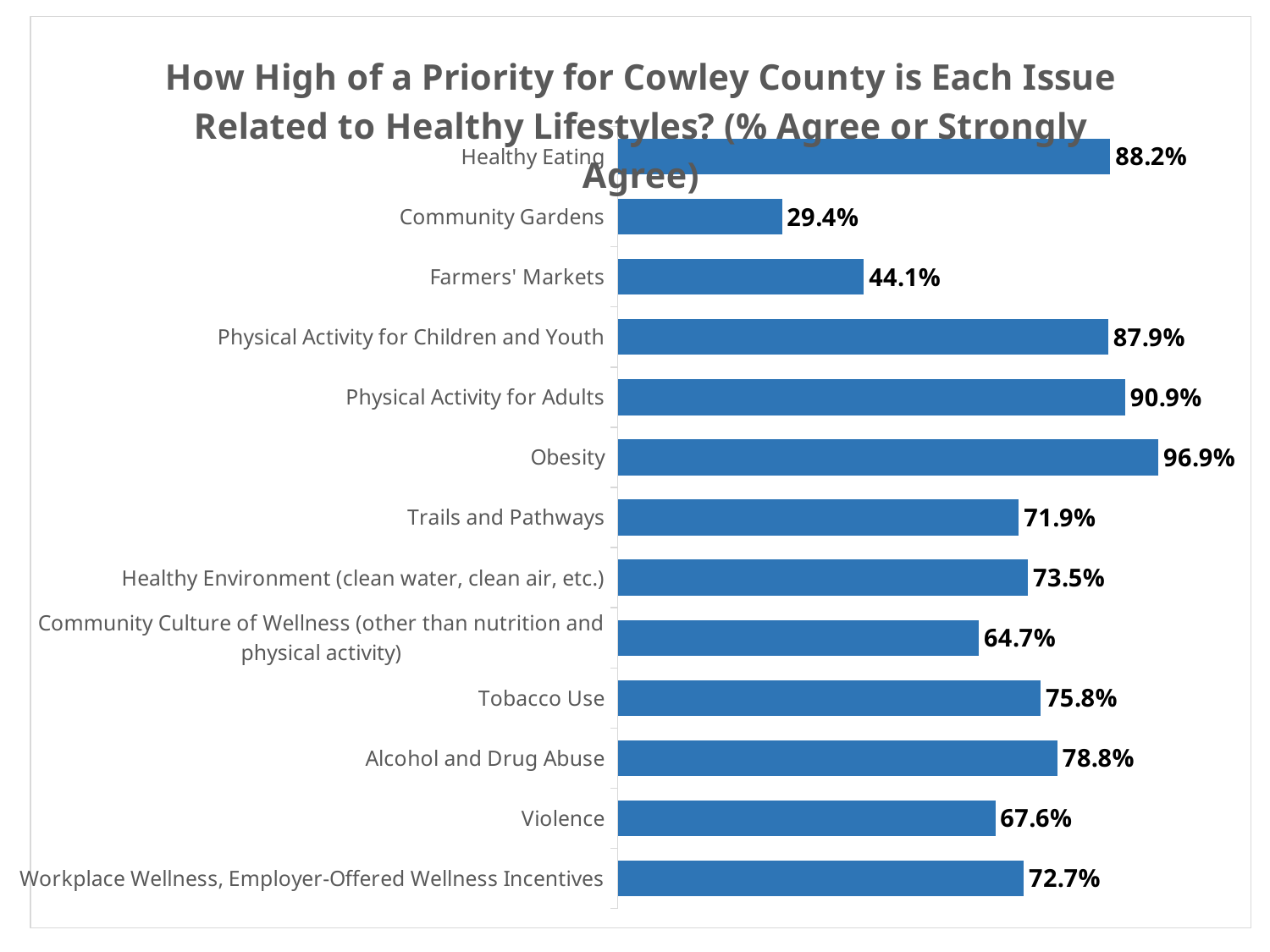
What is the value for Trails and Pathways? 71.9% Which issue has the lowest value? Community Gardens What is the value for Community Gardens? 29.4% What is the value for Workplace Wellness, Employer-Offered Wellness Incentives? 72.7% Which is larger, the value for Tobacco Use or the value for Violence? Tobacco Use How many issues are shown in the chart? 13 Which issue has the highest value? Obesity What kind of chart is this? Bar chart What is the difference between the values for Farmers' Markets and Community Gardens? 14.7% What is the value for Obesity? 96.9% What colour are the bars in the chart? Blue What is the difference between the values for Physical Activity for Adults and Physical Activity for Children and Youth? 3.0%